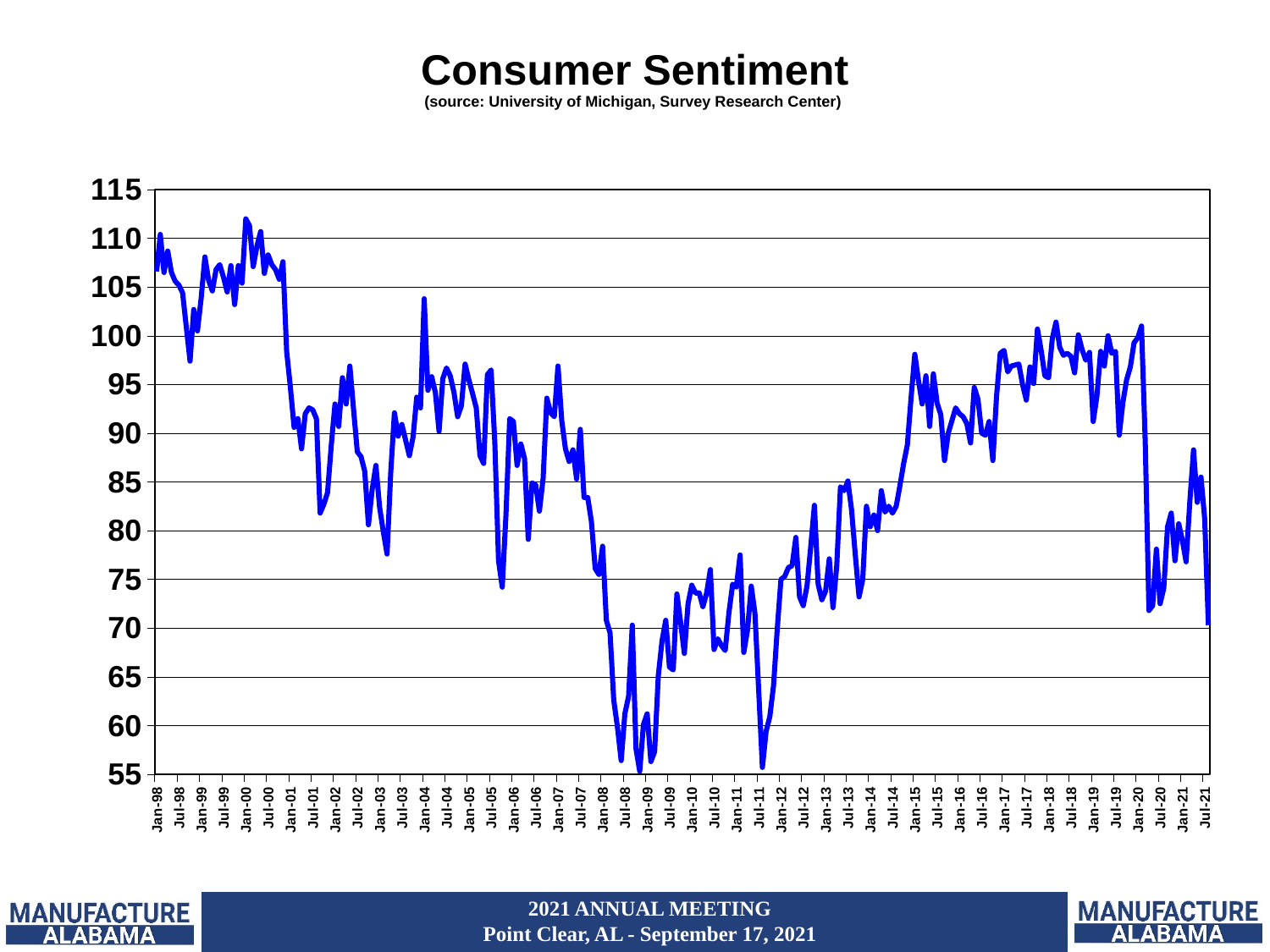
Does the line rise or fall between Jan-08 and Jan-09? fall Is the value for Jan-15 greater or less than 90? greater What is the title of the chart? Consumer Sentiment What kind of chart is shown on the slide? line chart Around which year does the line reach its highest point? 2000 Is the value for Jan-09 greater or less than 70? less What is the highest value shown on the vertical axis? 115 Is the value for Jul-21 greater or less than 75? greater What source is cited for the chart's data? University of Michigan, Survey Research Center